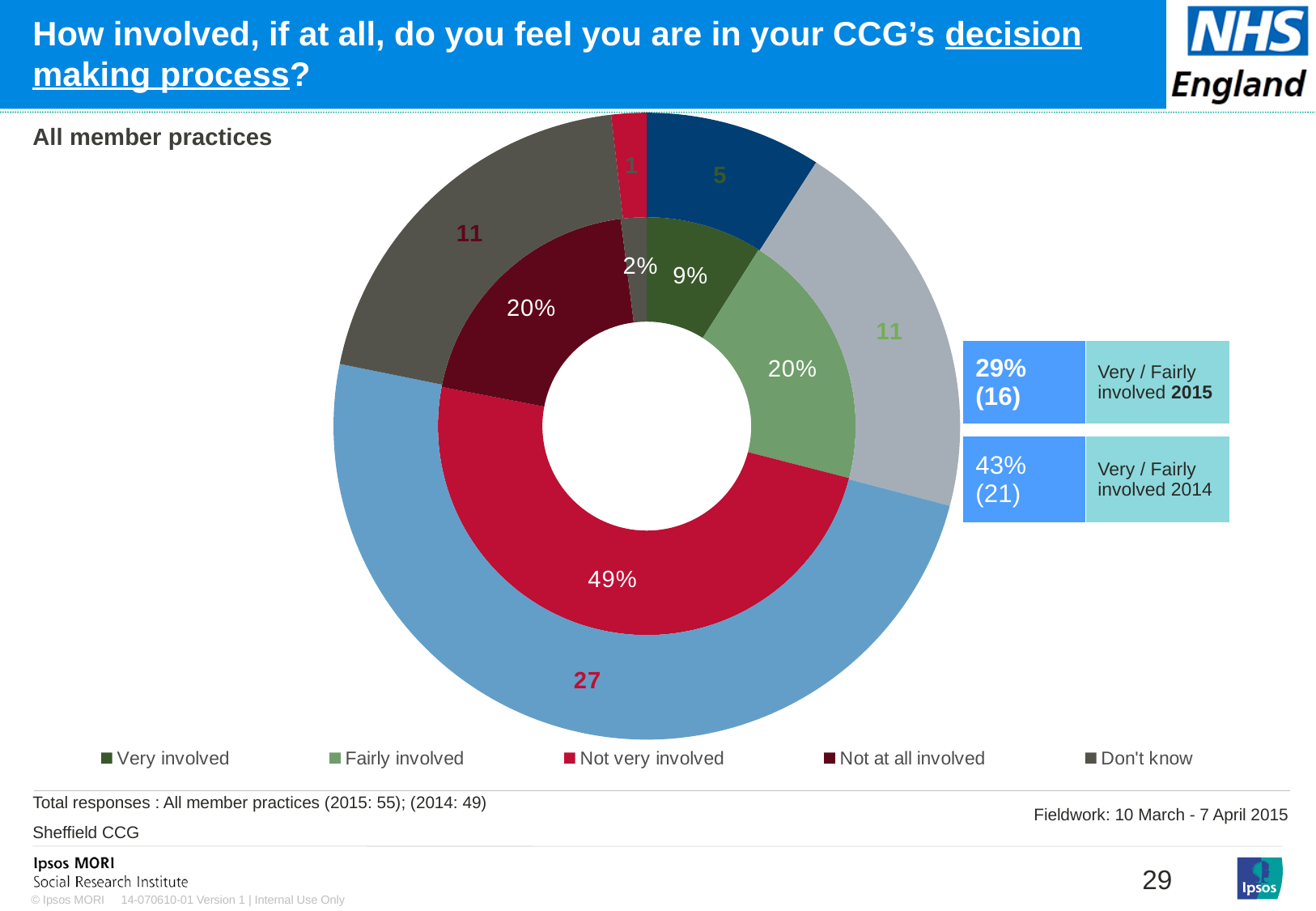
What percentage of member practices said they are 'Fairly involved'? 20% Which response category has the largest share of the doughnut chart? Not very involved What was the 'Very / Fairly involved' figure in 2014, as shown beside the chart? 43% (21) What percentage of member practices said they are 'Very involved'? 9% What is the difference in percentage points between 'Not very involved' and 'Not at all involved'? 29 percentage points What is the combined percentage for 'Very involved' and 'Fairly involved' in 2015, as shown in the box beside the chart? 29% (16) What percentage of member practices said they are 'Not very involved' in the CCG's decision making process? 49% What percentage of member practices answered 'Don't know'? 2% What type of chart is shown on the slide? Doughnut chart Which is larger, the share for 'Very involved' or the share for 'Fairly involved'? Fairly involved How many response categories does the legend list? 5 Which response category has the smallest share of the doughnut chart? Don't know